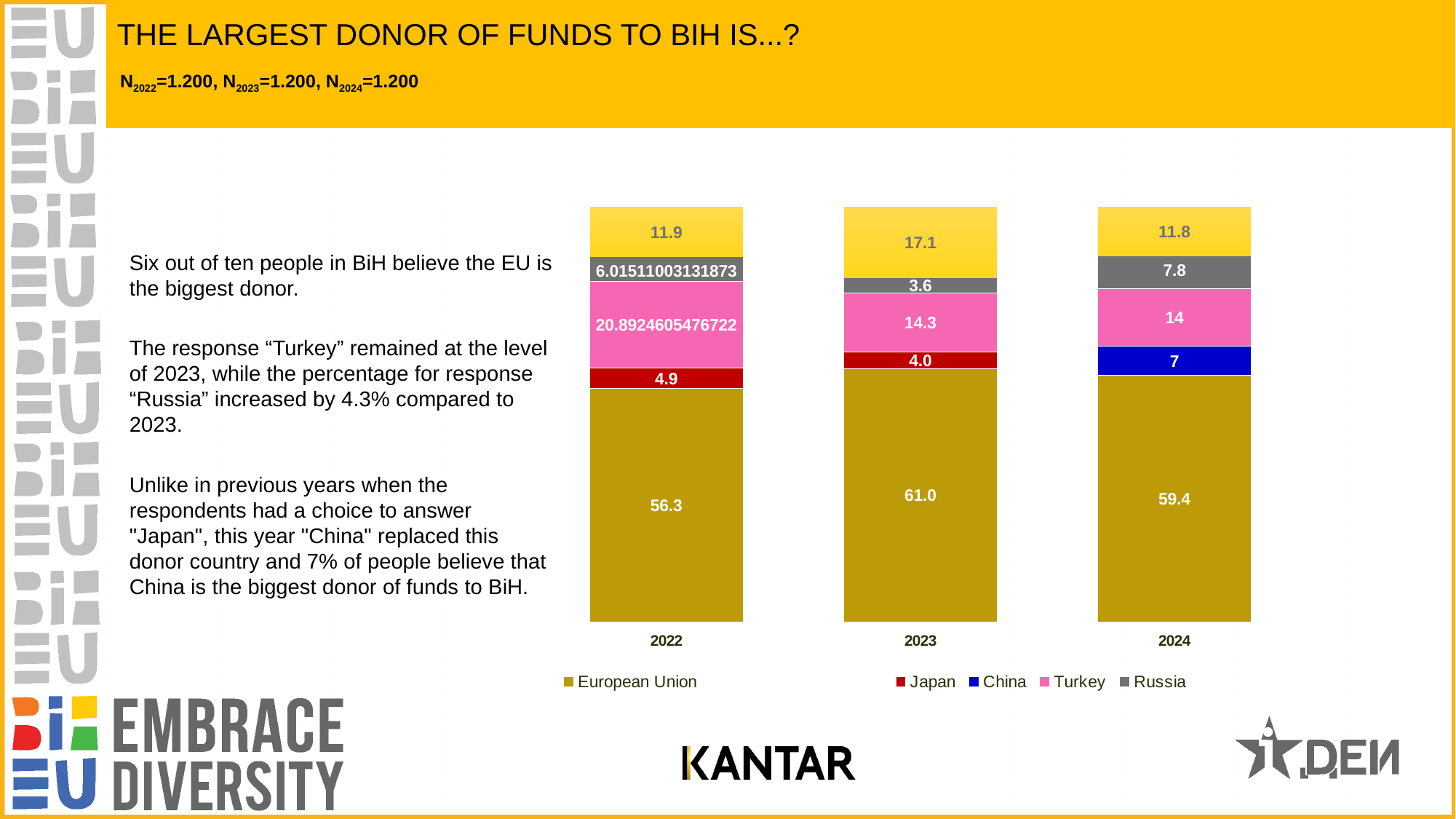
How many series does the legend list? 5 What is the value for European Union in 2023? 61.0 In which year is the European Union value the highest? 2023 By how much did the Russia value increase from 2023 to 2024? 4.2 How many years are shown on the x axis? 3 What kind of chart is shown on the slide? Stacked bar chart What is the value for China in 2024? 7 What is the value for Japan in 2022? 4.9 What is the value for Turkey in 2023? 14.3 Which is larger, the Turkey value in 2023 or in 2024? 2023 What is the value for Russia in 2024? 7.8 Does the Japan value rise or fall from 2022 to 2023? Fall